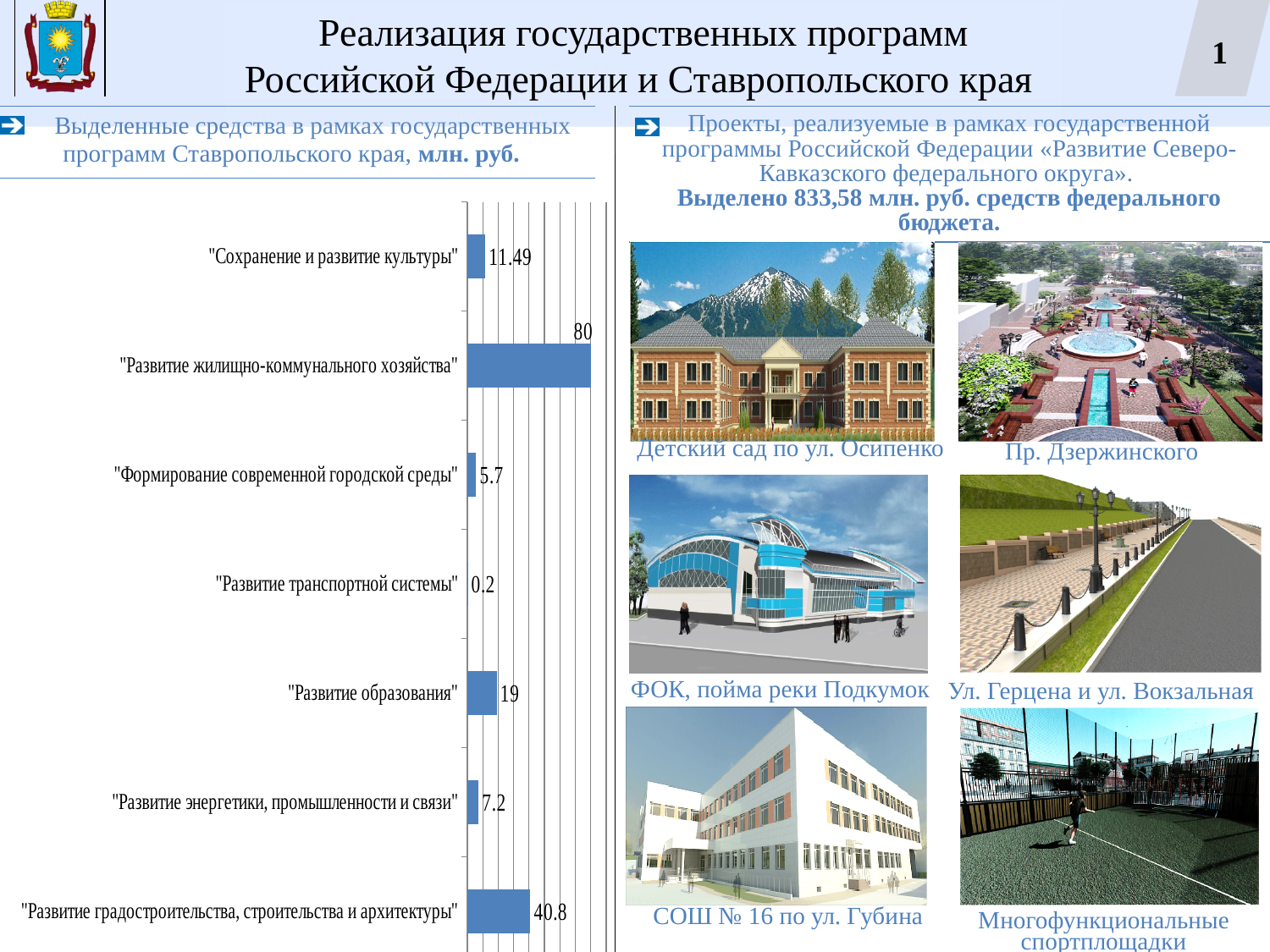
What is the difference between the values for "Развитие жилищно-коммунального хозяйства" and "Развитие градостроительства, строительства и архитектуры"? 39.2 Which program has the highest allocated amount? "Развитие жилищно-коммунального хозяйства" What value is shown for "Развитие градостроительства, строительства и архитектуры"? 40.8 What value is shown for "Развитие образования"? 19 What is the difference between the values for "Сохранение и развитие культуры" and "Формирование современной городской среды"? 5.79 How many programs (categories) are shown in the chart? 7 What kind of chart is shown on the slide? Bar chart Which is larger: the value for "Развитие образования" or for "Развитие энергетики, промышленности и связи"? "Развитие образования" Which program has the lowest allocated amount? "Развитие транспортной системы" What value is shown for "Развитие жилищно-коммунального хозяйства"? 80 In what units are the chart values given, according to the heading above the chart? млн. руб. What value is shown for "Сохранение и развитие культуры"? 11.49